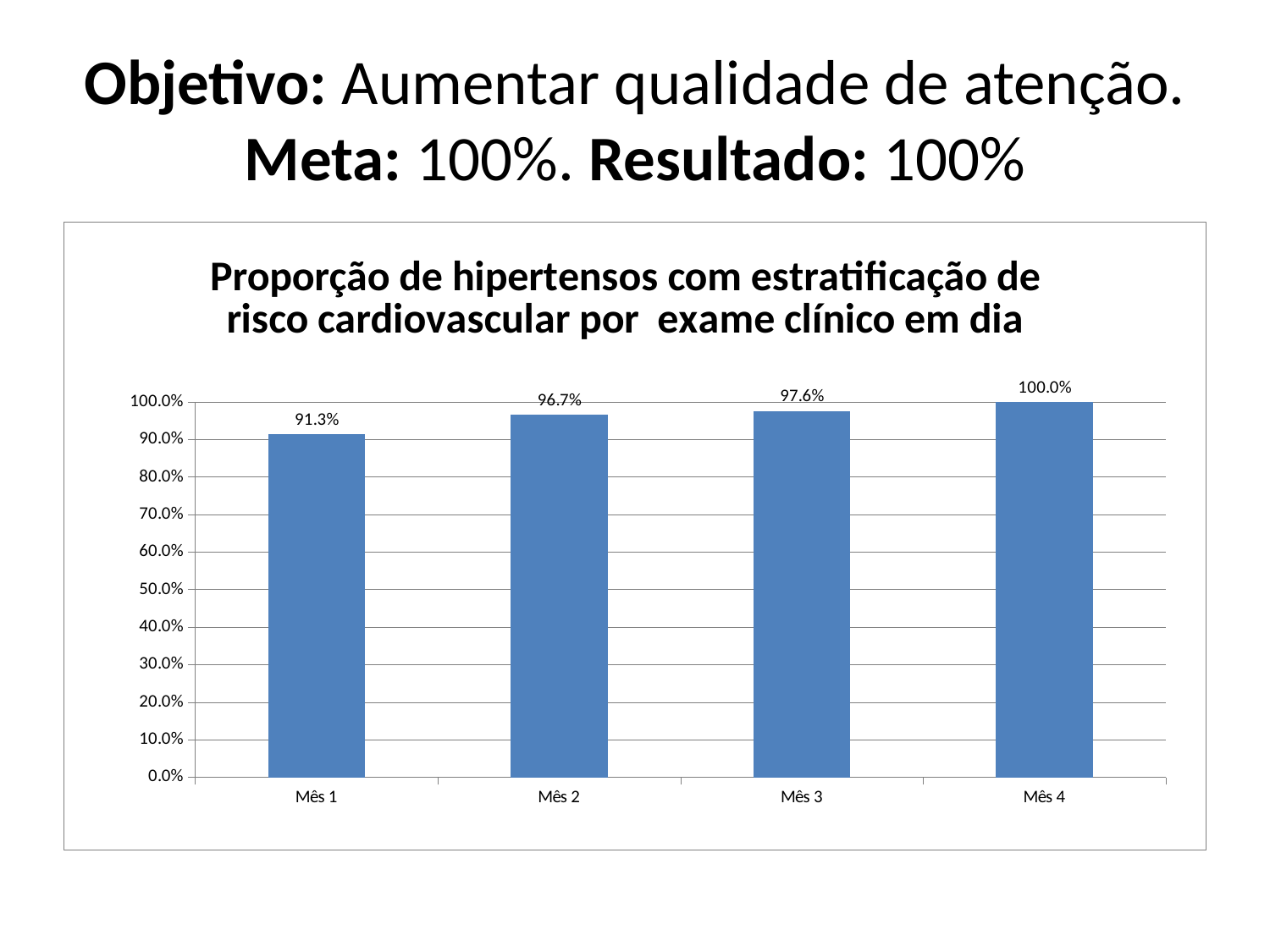
What is the value for Mês 4? 100.0% How many months are shown on the x axis? 4 What is the value for Mês 3? 97.6% Which month has the lowest value? Mês 1 What is the value for Mês 2? 96.7% Is the value for Mês 1 greater or less than 90.0%? greater Which is larger, the value for Mês 2 or the value for Mês 1? Mês 2 Do the values rise or fall from Mês 1 to Mês 4? rise Which month has the highest value? Mês 4 What kind of chart is shown? bar chart What is the difference between the values for Mês 4 and Mês 1? 8.7% What is the value for Mês 1? 91.3%